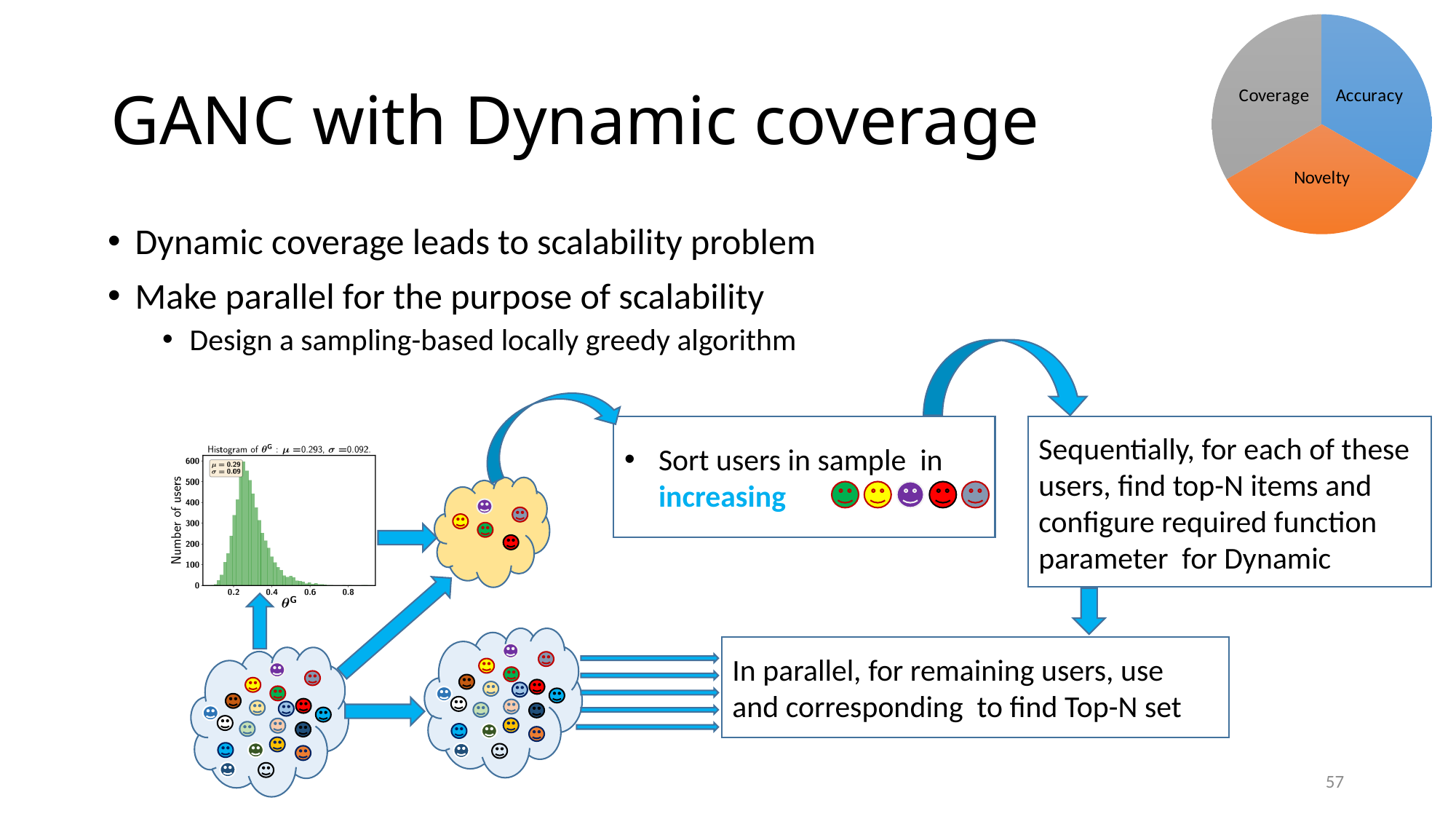
In the histogram on the left side of the slide, what value of μ is given in the chart title? 0.293 In the pie chart in the top-right corner, which slice is coloured orange? Novelty In the histogram on the left side of the slide, do the bar heights rise or fall as θ^G increases from 0.4 to 0.8? fall In the histogram on the left side of the slide, what value of σ is given in the chart title? 0.092 In the histogram on the left side of the slide, is the tallest bar greater or less than 400 users? greater What kind of chart is the histogram on the left side of the slide? Bar chart What are the labels of the three slices in the pie chart in the top-right corner? Coverage, Accuracy, Novelty In the histogram on the left side of the slide, what is the label of the y-axis? Number of users What kind of chart is shown in the top-right corner of the slide? Pie chart In the histogram on the left side of the slide, is the number of users at θ^G = 0.8 greater or less than 100? less How many slices does the pie chart in the top-right corner have? 3